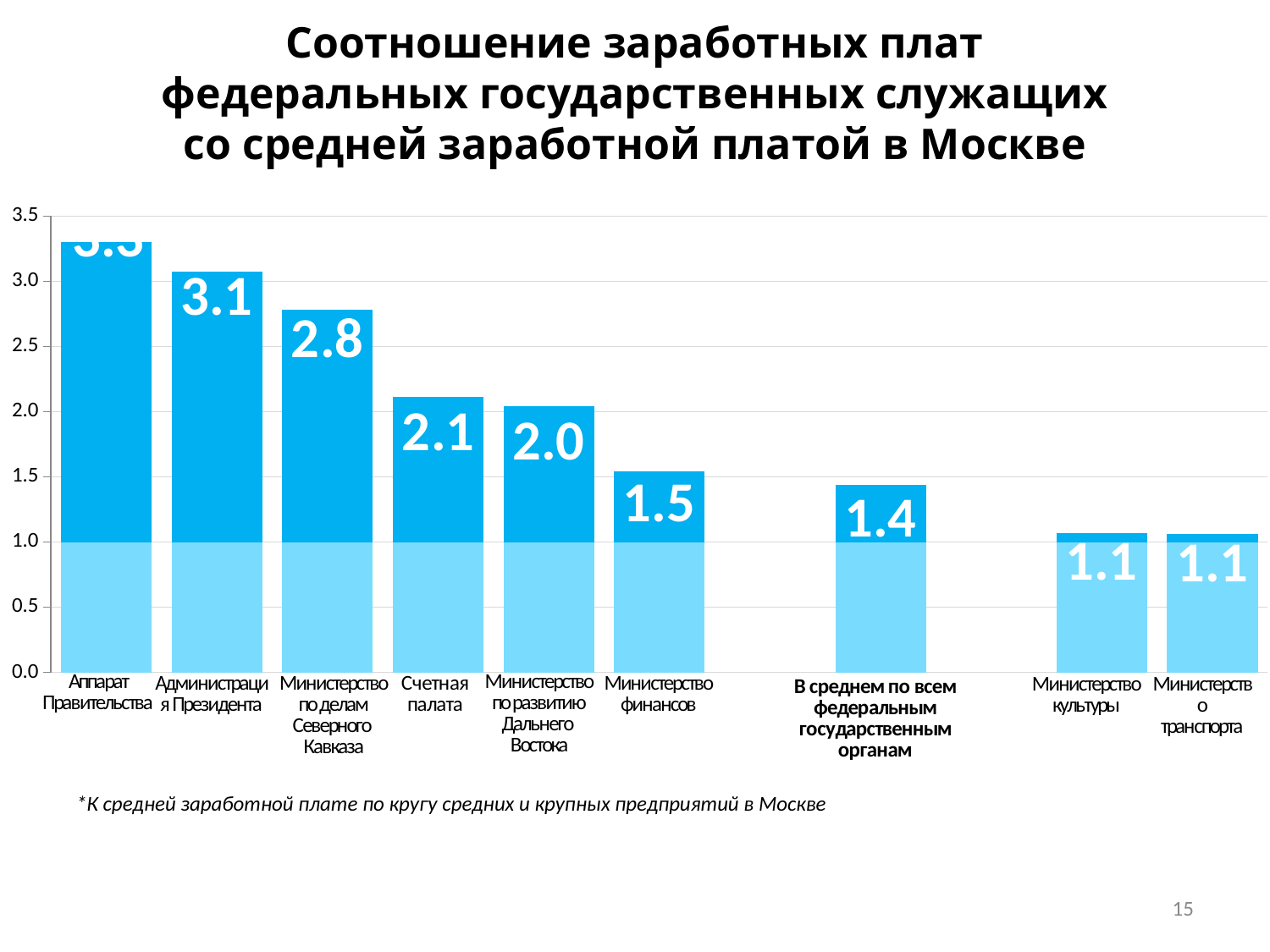
What kind of chart is shown on the slide? bar chart What is the value for В среднем по всем федеральным государственным органам? 1.4 Which category has the highest value? Аппарат Правительства What is the value for Министерство по делам Северного Кавказа? 2.8 What is the value for Министерство финансов? 1.5 What is the value for Счетная палата? 2.1 What is the difference between the values for Администрация Президента and Министерство по делам Северного Кавказа? 0.3 What is the value for Министерство культуры? 1.1 Which is larger, the value for Счетная палата or the value for Министерство финансов? Счетная палата What is the value for Администрация Президента? 3.1 Is the value for Аппарат Правительства greater or less than 3.0? greater How many categories are shown on the chart? 9